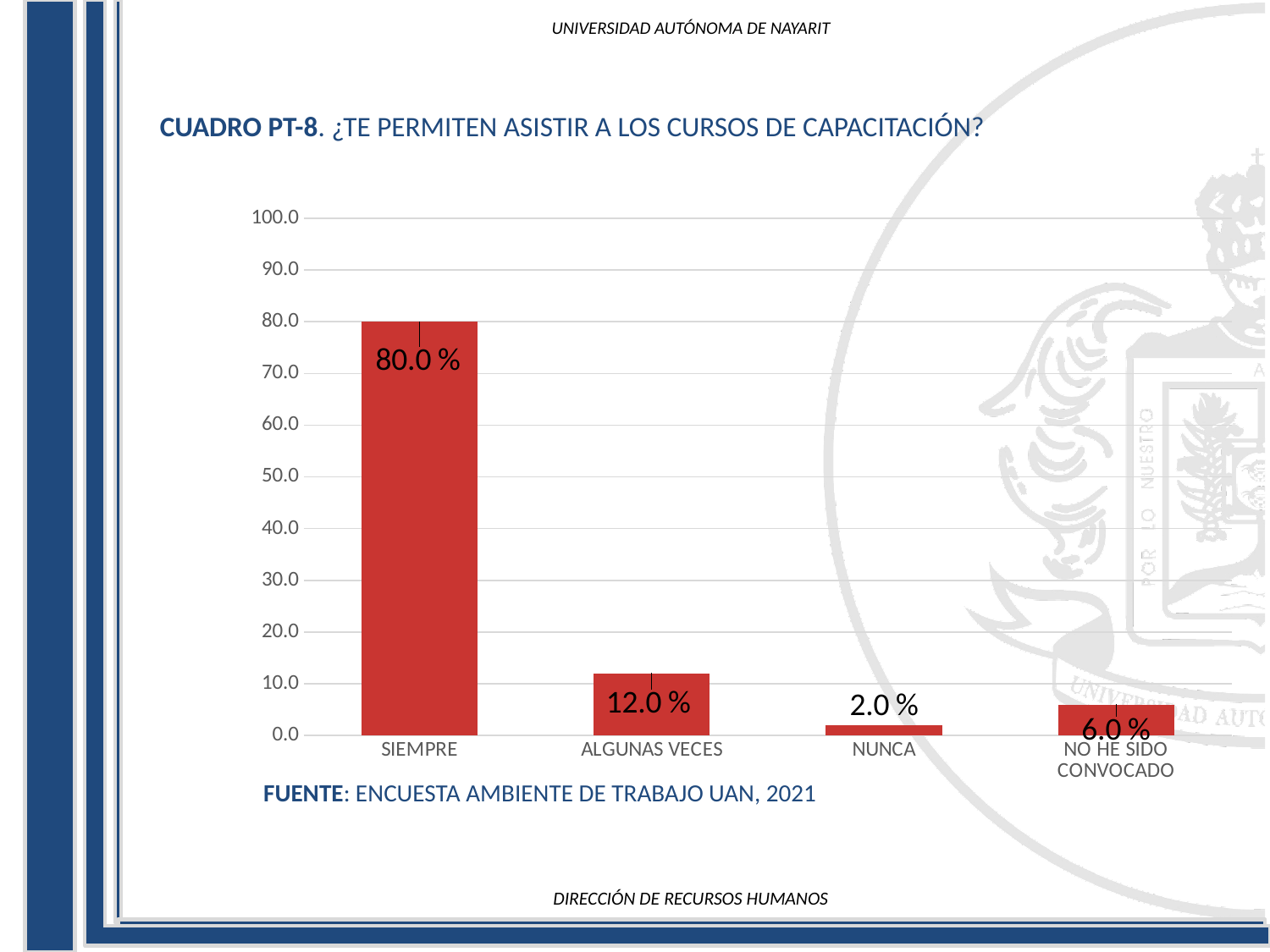
What is the value for SIEMPRE? 80.0 % What is the difference between the values for NO HE SIDO CONVOCADO and NUNCA? 4.0 % How many categories are shown on the x axis? 4 What is the value for ALGUNAS VECES? 12.0 % Which category has the lowest value? NUNCA Which category has the highest value? SIEMPRE What is the value for NUNCA? 2.0 % What is the difference between the values for SIEMPRE and ALGUNAS VECES? 68.0 % Which is larger, the value for ALGUNAS VECES or the value for NO HE SIDO CONVOCADO? ALGUNAS VECES What is the value for NO HE SIDO CONVOCADO? 6.0 % What kind of chart is shown on the slide? bar chart What is the source cited below the chart? ENCUESTA AMBIENTE DE TRABAJO UAN, 2021